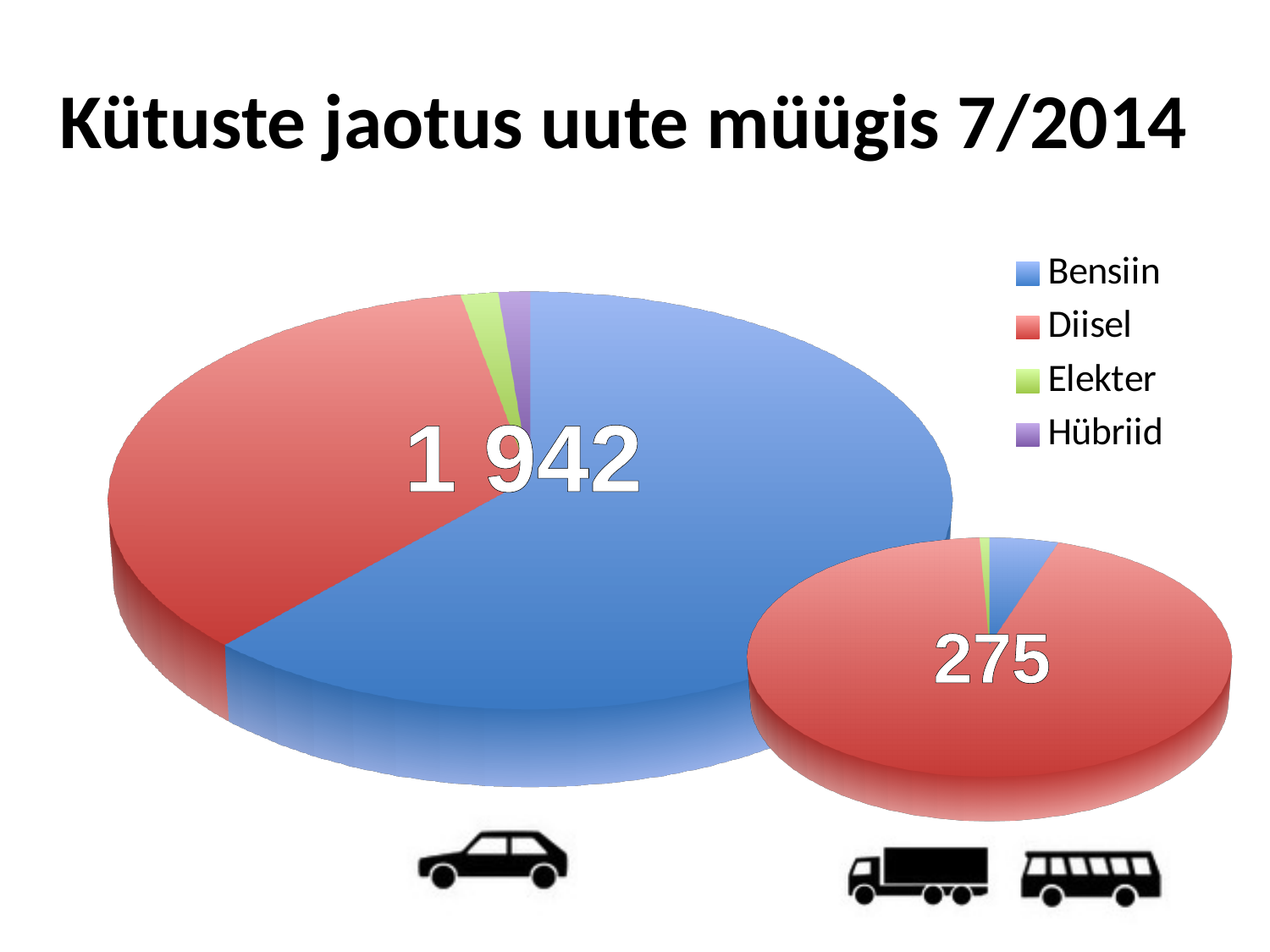
What kind of charts are shown on the slide? Pie charts What is the difference between the number printed on the left pie chart and the number printed on the right pie chart? 1 667 Which colour represents Diisel in the legend? Red In the right pie chart, which slice is larger, Diisel or Bensiin? Diisel What number is printed in the centre of the left (larger) pie chart? 1 942 In the left pie chart, which category has the largest slice? Bensiin How many categories does the legend list? 4 In the right pie chart, which category has the largest slice? Diisel What number is printed in the centre of the right (smaller) pie chart? 275 How many pie charts are on the slide? 2 In the left pie chart, which slice is larger, Bensiin or Diisel? Bensiin What is the title of the slide? Kütuste jaotus uute müügis 7/2014